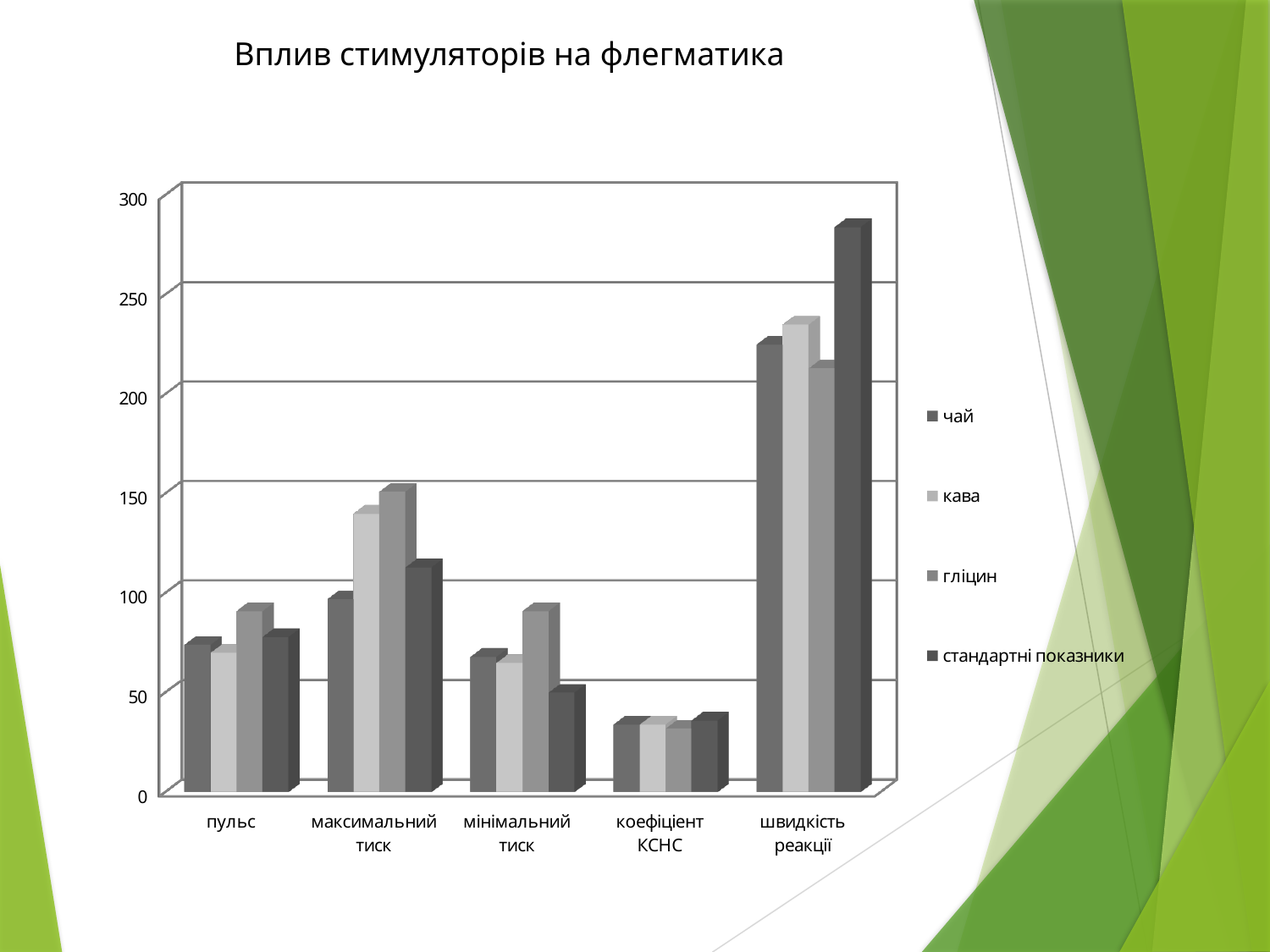
Is the value of стандартні показники for швидкість реакції greater or less than 250? greater For максимальний тиск, which is larger: кава or чай? кава For мінімальний тиск, which is larger: гліцин or стандартні показники? гліцин Which category has the lowest value for the series чай? коефіцієнт КСНС Is the value of кава for швидкість реакції greater or less than 200? greater How many categories are shown along the x axis of the chart? 5 How many series does the chart's legend list? 4 Is the value of стандартні показники for мінімальний тиск greater or less than 100? less What is the title of the slide? Вплив стимуляторів на флегматика What kind of chart is shown on the slide? bar chart Which category has the highest value for the series стандартні показники? швидкість реакції